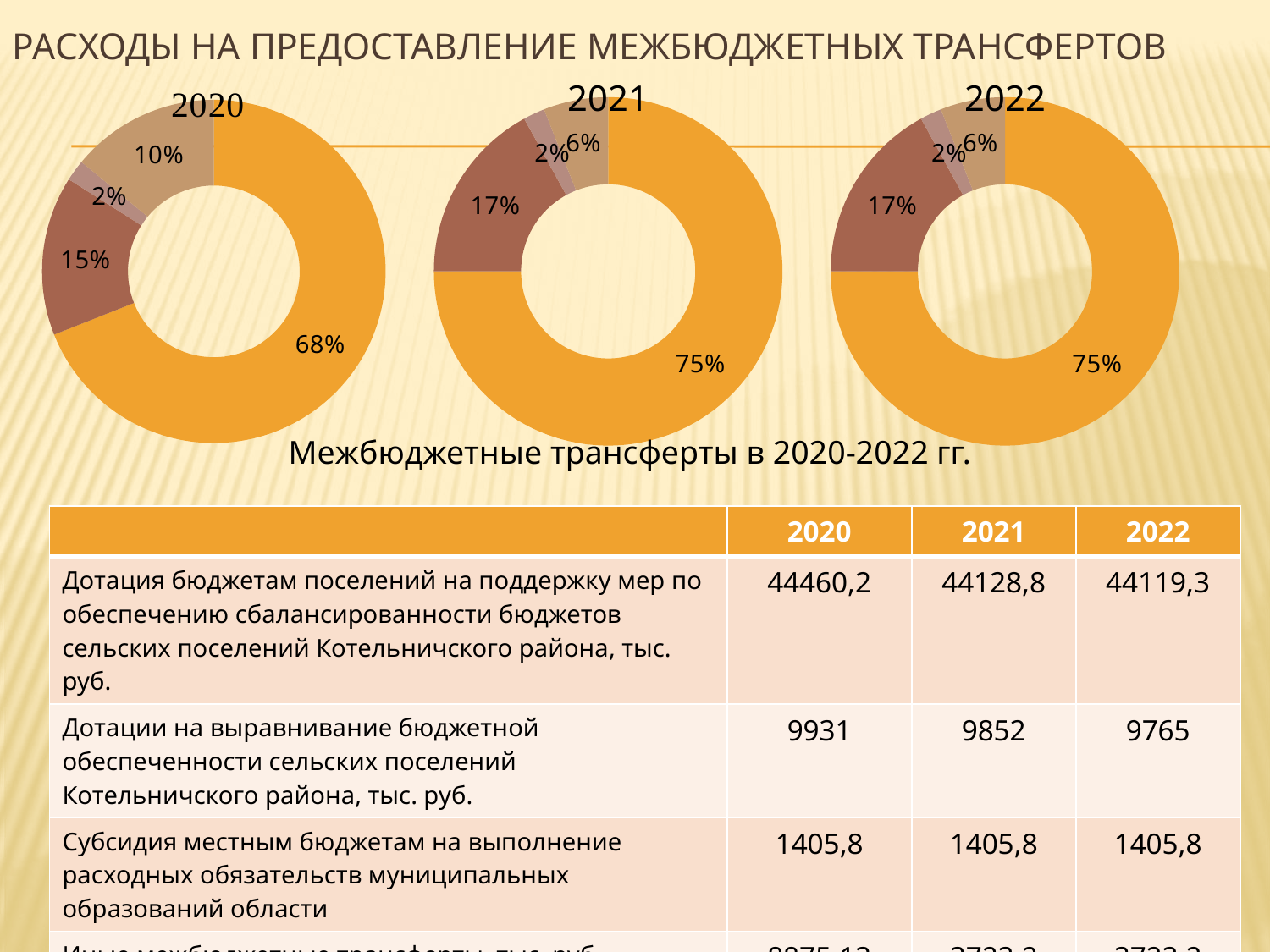
In the 2020 chart, how many slices does the pie have? 4 In the 2021 chart, what is the share of the second-largest slice? 17% In the 2020 chart, what is the share of the second-largest slice? 15% Which chart has the larger biggest slice, 2020 or 2022? 2022 In the 2021 chart, what is the share of the largest slice? 75% What caption is written below the three pie charts? Межбюджетные трансферты в 2020-2022 гг. By how many percentage points is the largest slice in the 2021 chart bigger than the largest slice in the 2020 chart? 7 In the 2022 chart, what is the share of the smallest slice? 2% In the 2020 chart, what is the share of the smallest slice? 2% In the 2020 chart, what is the share of the largest slice? 68% How many pie charts are shown on the slide? 3 What kind of chart is used for the 2020, 2021 and 2022 charts on the slide? pie chart (doughnut)